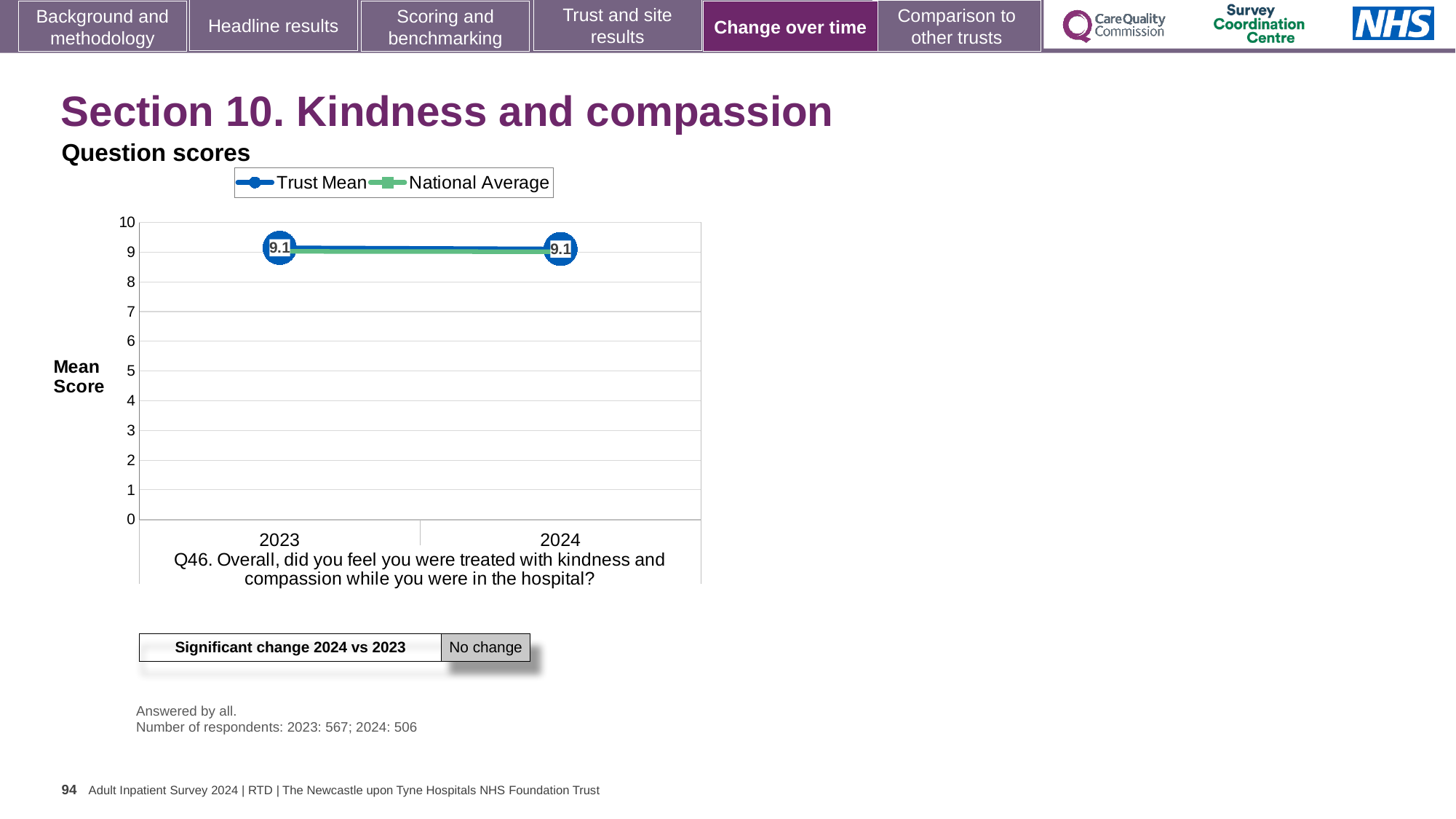
What is the difference between the Trust Mean scores for 2024 and 2023? 0 What is the label of the vertical axis of the chart? Mean Score How many years are shown on the x axis of the chart? 2 What is the Trust Mean score for 2024? 9.1 Is the Trust Mean for 2024 higher, lower, or the same as the Trust Mean for 2023? the same How many series does the chart legend list? 2 What kind of chart is shown on the slide? line chart Is the National Average value for 2024 greater or less than 5? greater Does the Trust Mean rise, fall, or stay flat from 2023 to 2024? stays flat What are the two series named in the chart legend? Trust Mean and National Average Is the National Average value for 2023 greater or less than 8? greater What is the Trust Mean score for 2023? 9.1